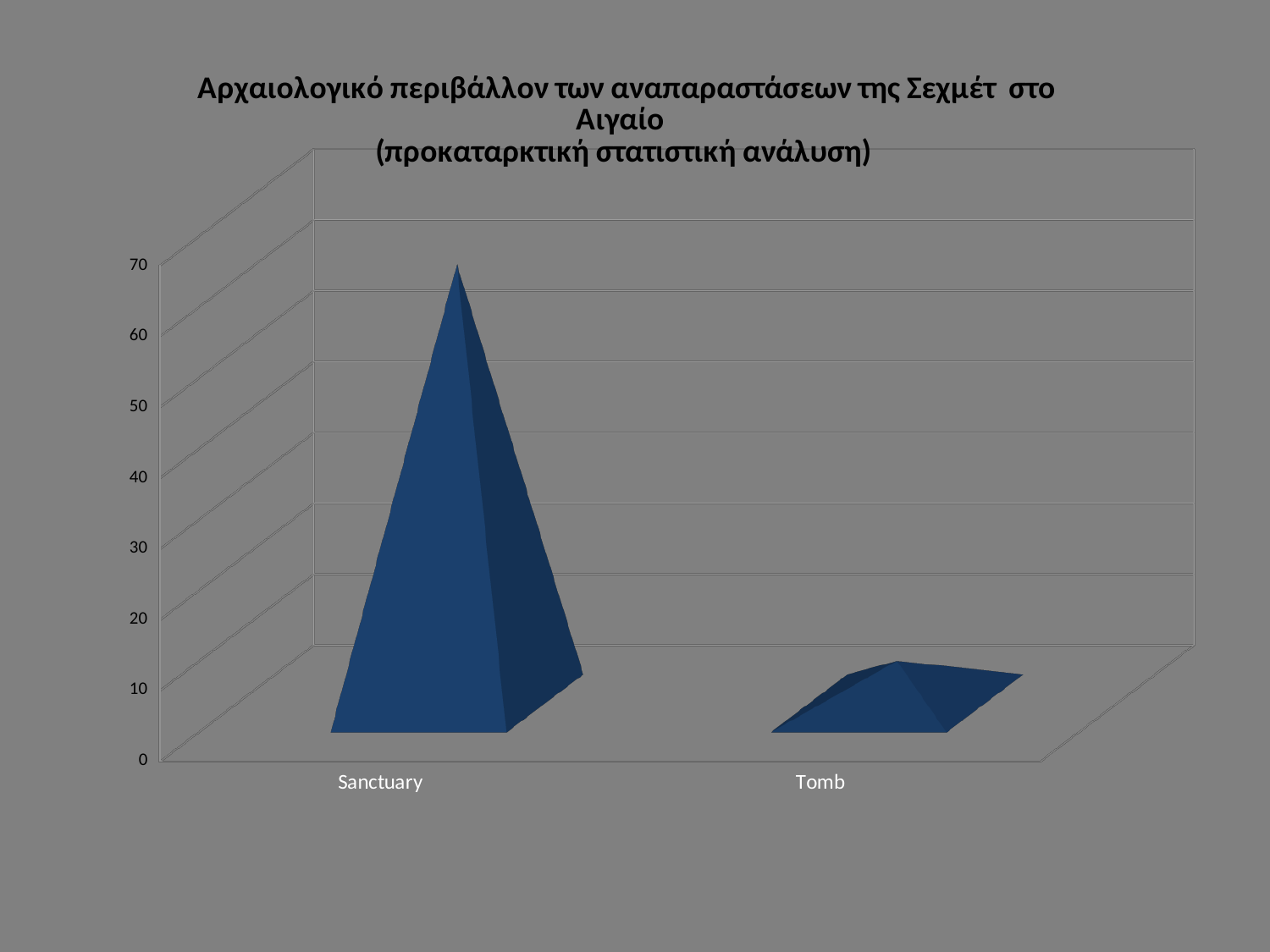
Which category has the lowest value in the chart? Tomb What kind of chart is shown on the slide? bar chart Which category has the highest value in the chart? Sanctuary Is the value for Sanctuary greater or less than 20? greater What is the highest value shown on the vertical axis of the chart? 70 How many categories are shown on the x axis of the chart? 2 What colour are the bars in the chart? blue Is the value for Tomb greater or less than 30? less Is the value for Sanctuary greater or less than 40? greater Which is larger, the value for Sanctuary or the value for Tomb? Sanctuary